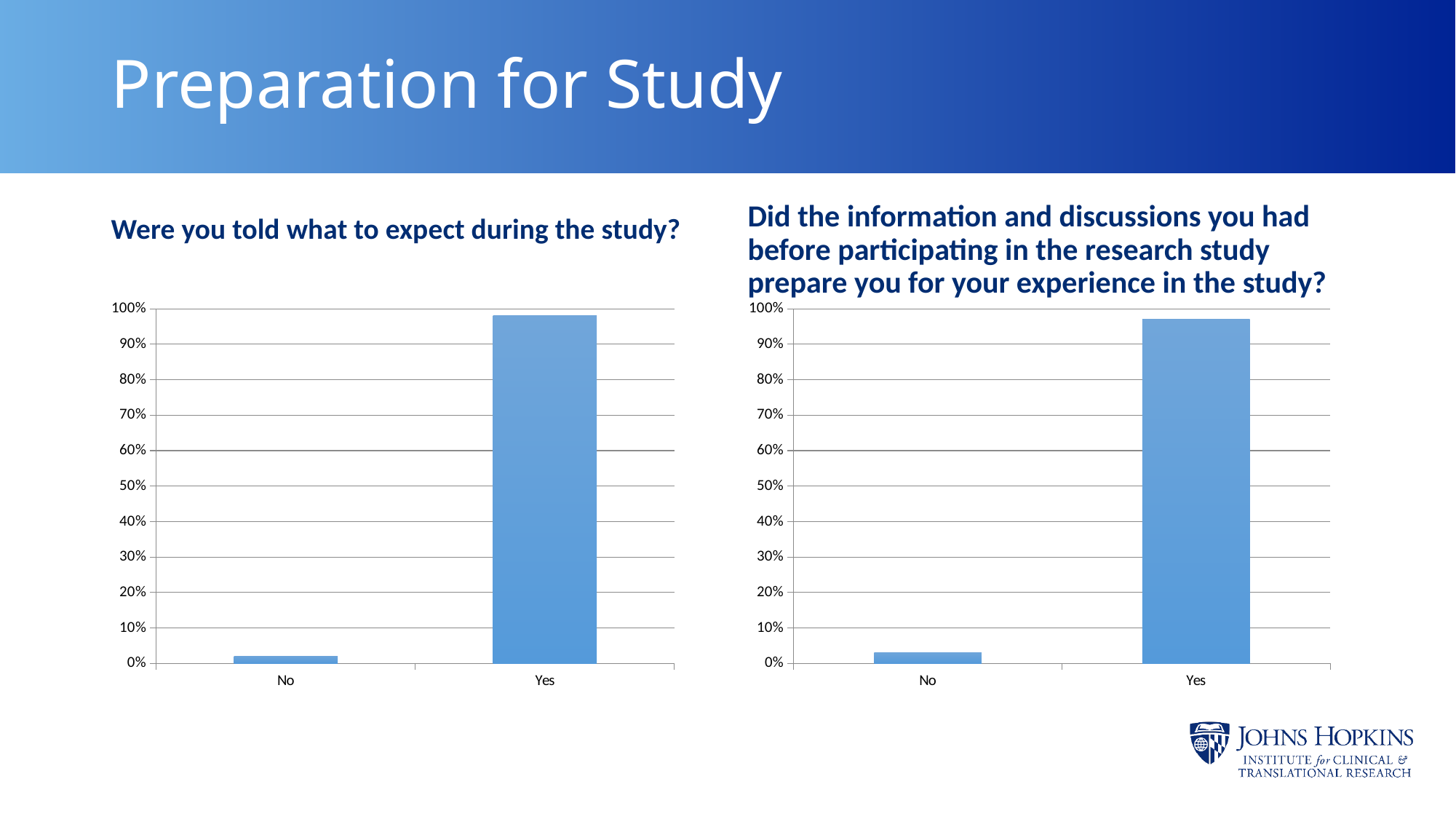
How many categories are shown in the left chart 'Were you told what to expect during the study?'? 2 What kind of chart is the left chart 'Were you told what to expect during the study?'? bar chart In the right chart about whether information and discussions prepared you for the study, which category has the highest value? Yes In the right chart about whether information and discussions prepared you for the study, which category has the lowest value? No In the left chart 'Were you told what to expect during the study?', which category has the highest value? Yes In the right chart about whether information and discussions prepared you for the study, is the value for No greater or less than 10%? less In the left chart 'Were you told what to expect during the study?', is the value for Yes greater or less than 90%? greater What is the title of the left chart on the slide? Were you told what to expect during the study? In the left chart 'Were you told what to expect during the study?', which category has the lowest value? No In the left chart 'Were you told what to expect during the study?', is the value for No greater or less than 10%? less In the right chart about whether information and discussions prepared you for the study, which is larger, the value for No or the value for Yes? Yes